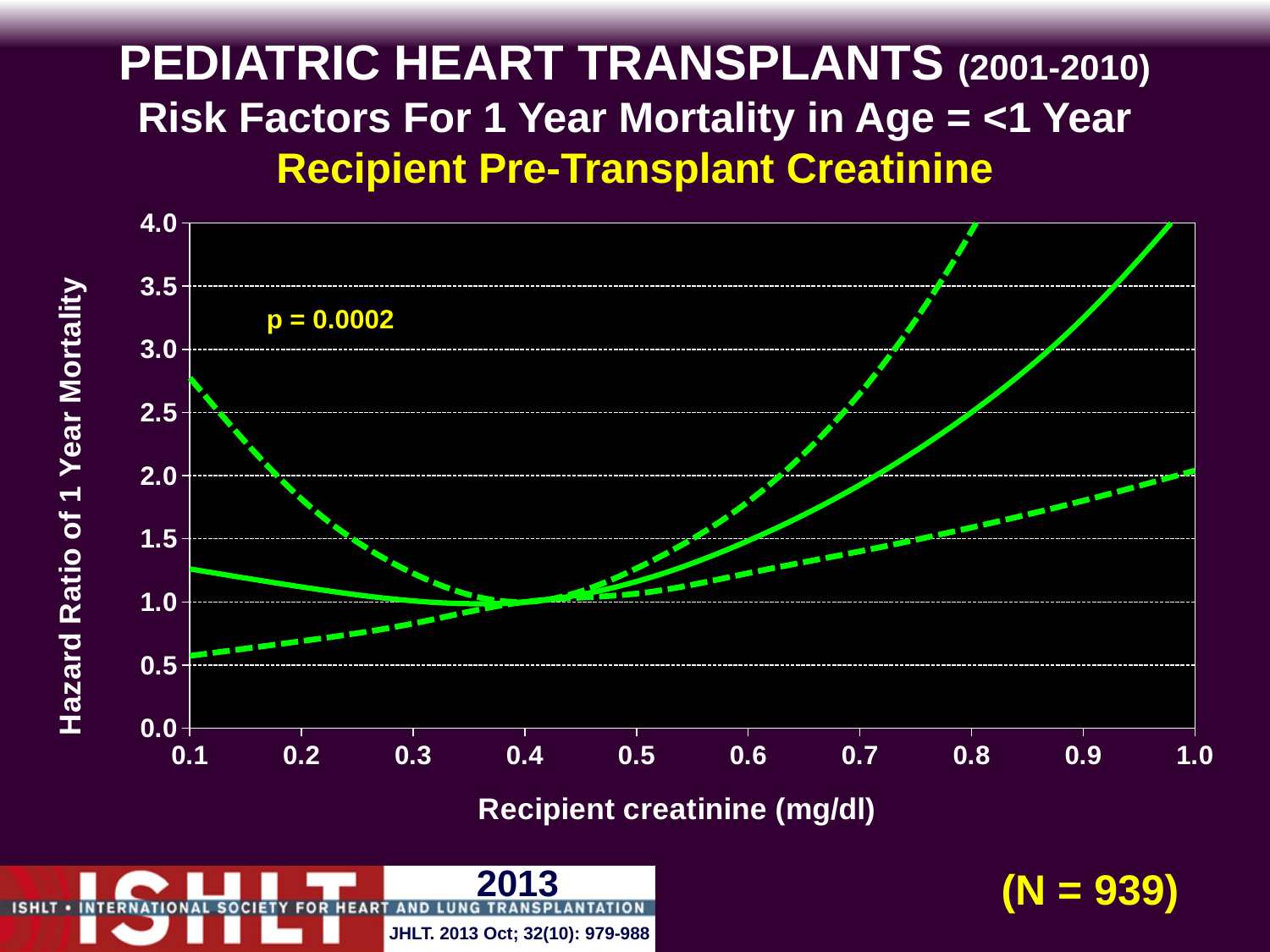
What is the highest value shown on the y axis of the chart? 4.0 Is the lower dashed line at a recipient creatinine of 1.0 mg/dl greater or less than 2.5? less Is the upper dashed line at a recipient creatinine of 0.1 mg/dl greater or less than 2.5? greater How many lines are plotted on the chart? 3 Is the lower dashed line at a recipient creatinine of 0.1 mg/dl greater or less than 1.0? less Does the solid hazard ratio line rise or fall as recipient creatinine increases from 0.5 to 1.0 mg/dl? rise What sample size (N) is shown on the slide? N = 939 What p-value is printed on the chart? p = 0.0002 What kind of chart is shown on the slide? line chart